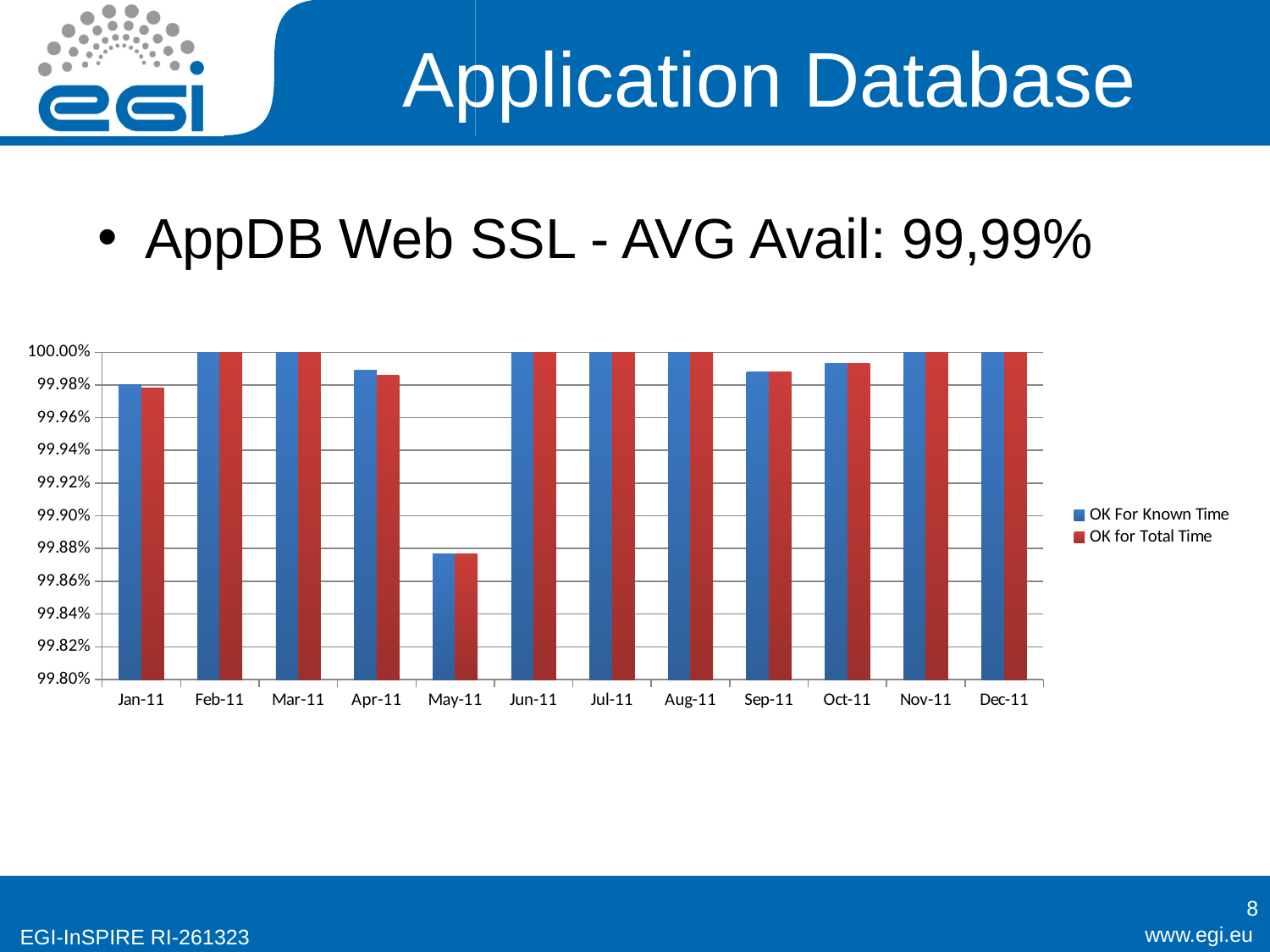
What is the value of OK For Known Time for Feb-11? 100.00% How many months are shown on the x axis of the chart? 12 Which month has the lowest availability in the chart? May-11 Is the value of OK For Known Time for May-11 greater or less than 99.90%? less Is the value of OK For Known Time for Oct-11 greater or less than 99.98%? greater What colour are the OK for Total Time bars in the chart? red What is the value of OK for Total Time for Dec-11? 100.00% What are the two series named in the chart legend? OK For Known Time and OK for Total Time How many series does the chart legend list? 2 Which is larger, the OK For Known Time value for May-11 or for Jun-11? Jun-11 What kind of chart is shown on the slide? bar chart Is the value of OK for Total Time for Apr-11 greater or less than 99.98%? greater